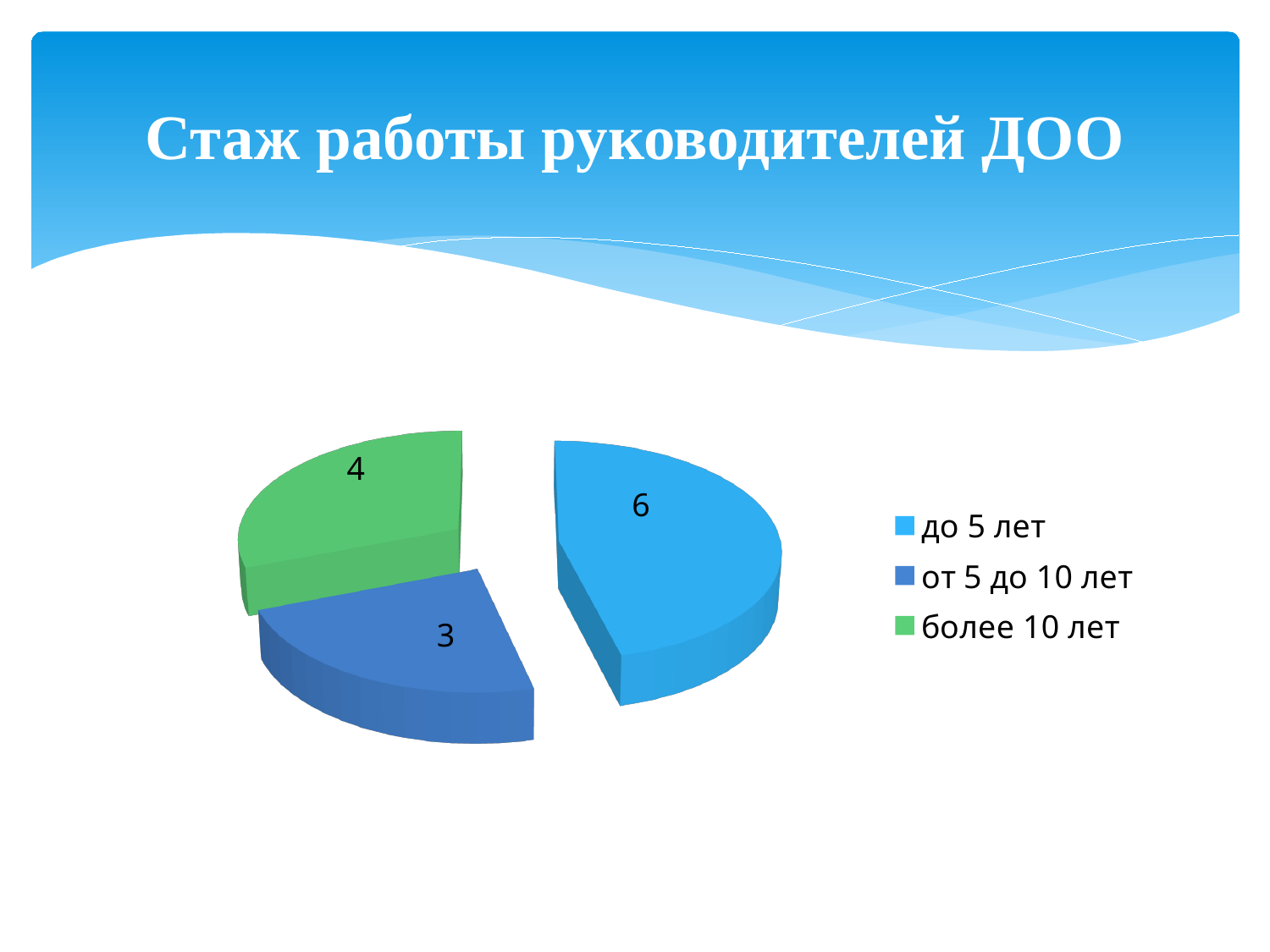
What is the total of all slices in the pie chart? 13 What kind of chart is shown on the slide? pie chart Which category has the lowest value? от 5 до 10 лет What is the difference between the values for "до 5 лет" and "от 5 до 10 лет"? 3 What is the difference between the values for "более 10 лет" and "от 5 до 10 лет"? 1 Which is larger, the value for "более 10 лет" or the value for "от 5 до 10 лет"? более 10 лет What is the value for "до 5 лет"? 6 What is the value for "от 5 до 10 лет"? 3 How many slices does the pie chart have? 3 What is the title of the chart? Стаж работы руководителей ДОО Which category has the highest value? до 5 лет What is the value for "более 10 лет"? 4